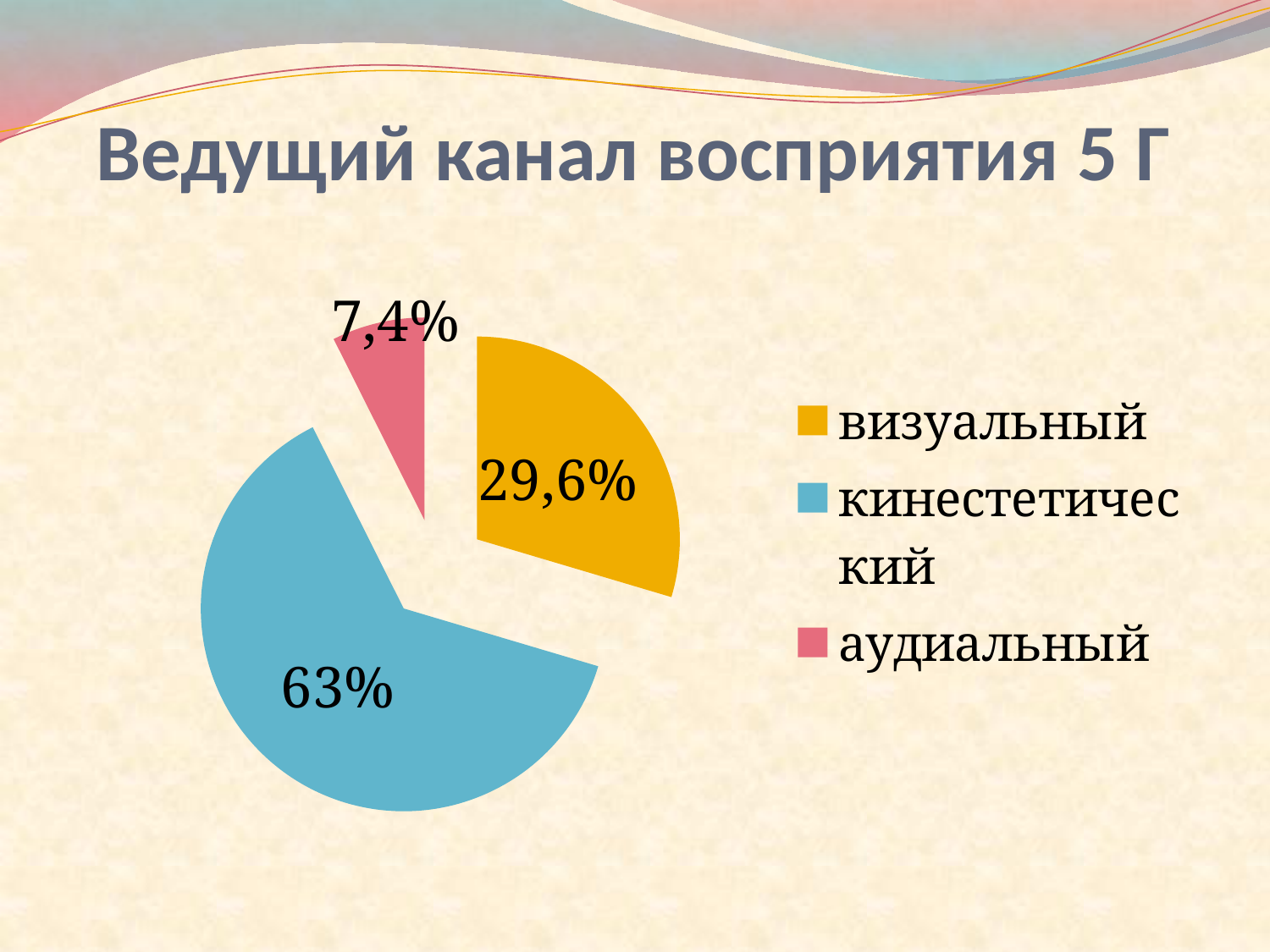
What is the value for кинестетический? 63% What is the value for аудиальный? 7,4% Which is larger, визуальный or аудиальный? визуальный What colour is the slice for аудиальный? pink What is the value for визуальный? 29,6% Which category has the smallest share of the pie? аудиальный What is the title of the slide? Ведущий канал восприятия 5 Г Which category has the largest share of the pie? кинестетический What is the difference between the values for визуальный and аудиальный? 22,2% What is the difference between the values for кинестетический and визуальный? 33,4% How many slices does the pie chart have? 3 What type of chart is shown on the slide? pie chart